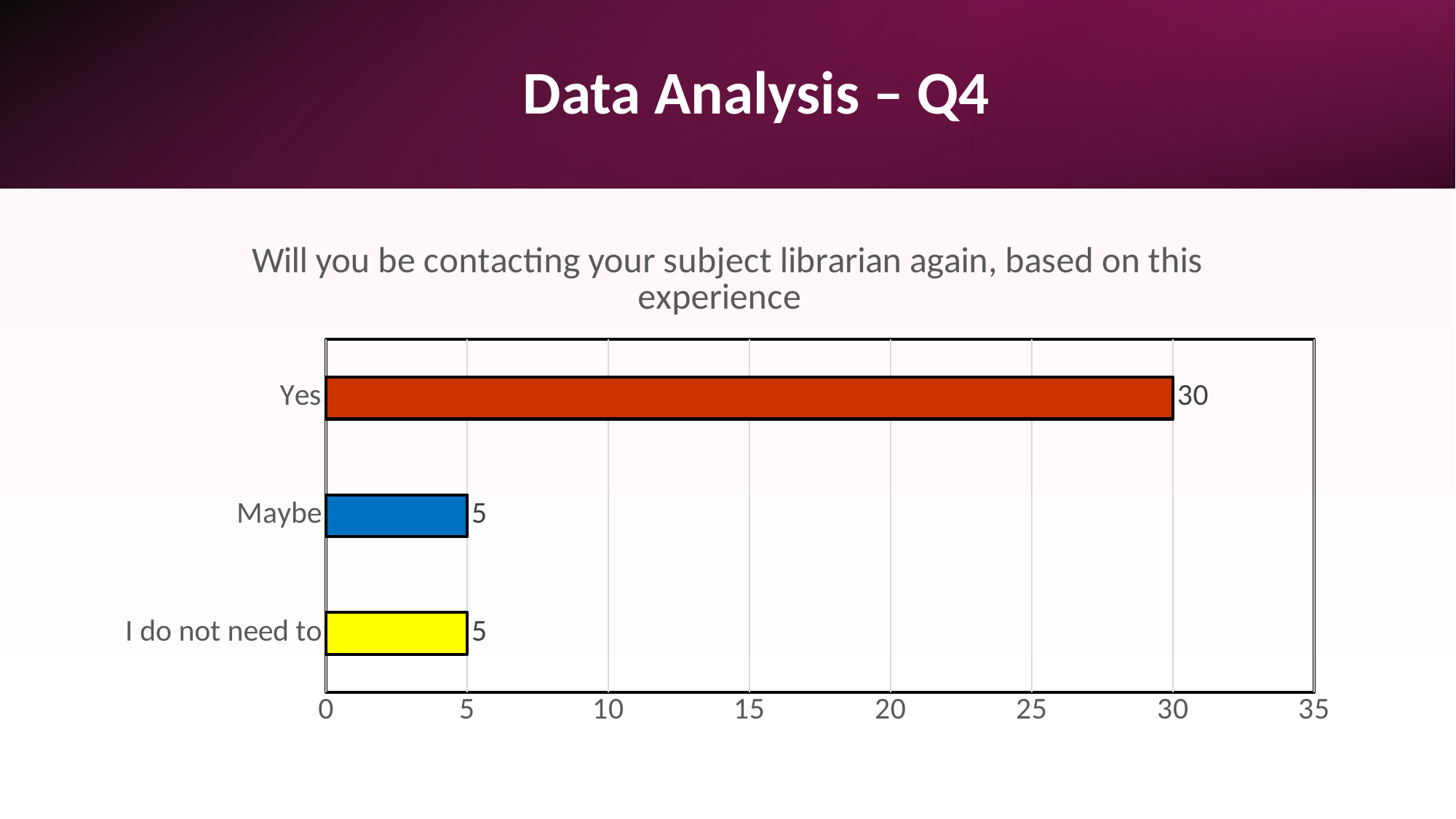
Is the value for Maybe greater or less than 10? less What is the difference between the values for Yes and Maybe? 25 What is the value for Maybe? 5 What is the value for Yes? 30 How many categories are shown in the chart? 3 Which is larger, the value for Yes or the value for I do not need to? Yes Which category has the highest value? Yes Is the value for Yes greater or less than 25? greater What is the title of the chart? Will you be contacting your subject librarian again, based on this experience What kind of chart is shown on the slide? bar chart What colour is the bar for Maybe? blue What is the value for I do not need to? 5